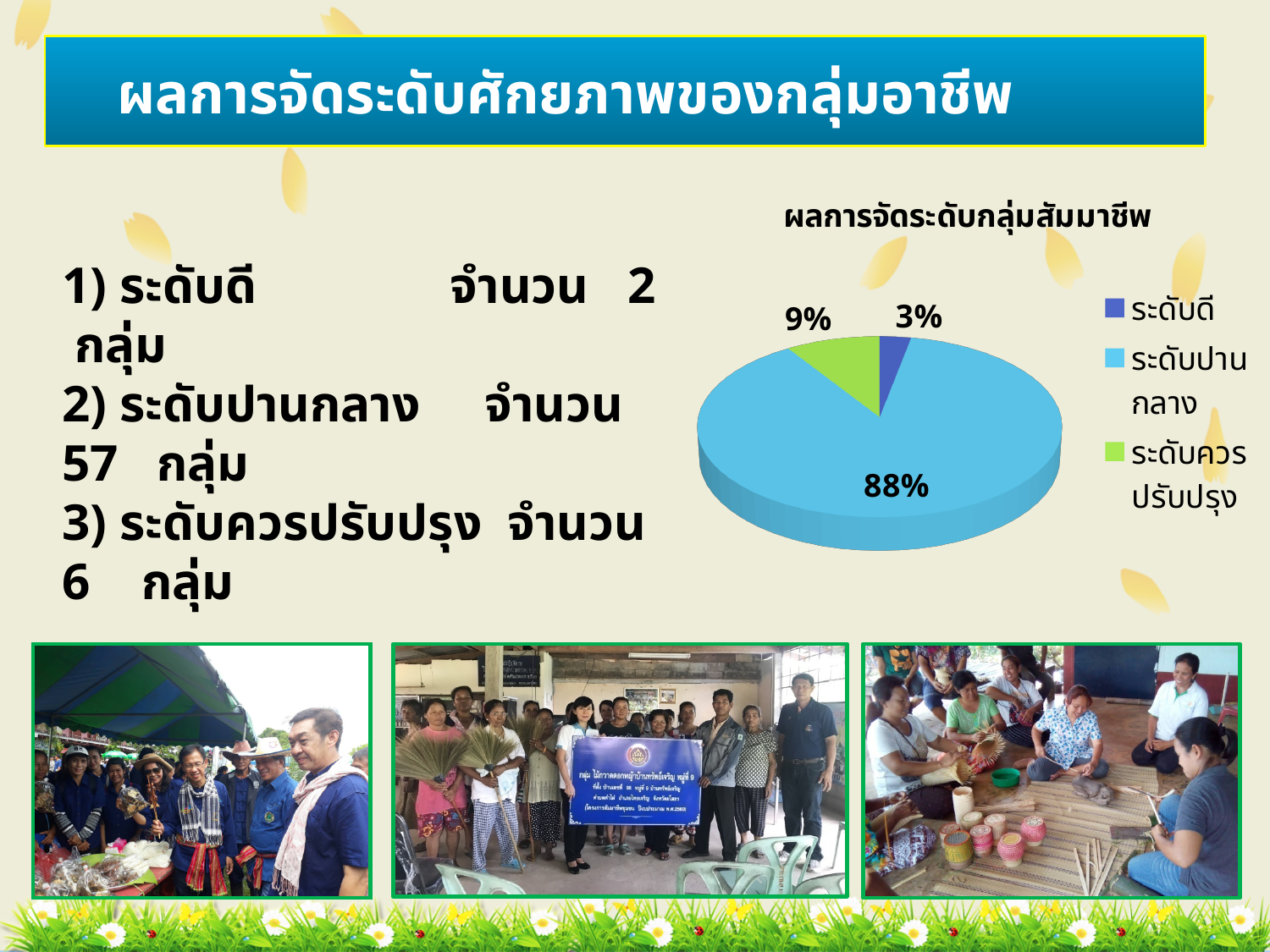
What percentage of the pie does ระดับดี represent? 3% What is the title of the chart? ผลการจัดระดับกลุ่มสัมมาชีพ How many entries does the legend list? 3 What percentage of the pie does ระดับควรปรับปรุง represent? 9% Which category has the largest slice of the pie? ระดับปานกลาง What percentage of the pie does ระดับปานกลาง represent? 88% What kind of chart is shown on the slide? pie chart Which is larger, the slice for ระดับควรปรับปรุง or the slice for ระดับดี? ระดับควรปรับปรุง What is the difference in percentage points between ระดับปานกลาง and ระดับควรปรับปรุง? 79 How many categories does the pie chart show? 3 What colour is the slice for ระดับควรปรับปรุง? green Which category has the smallest slice of the pie? ระดับดี